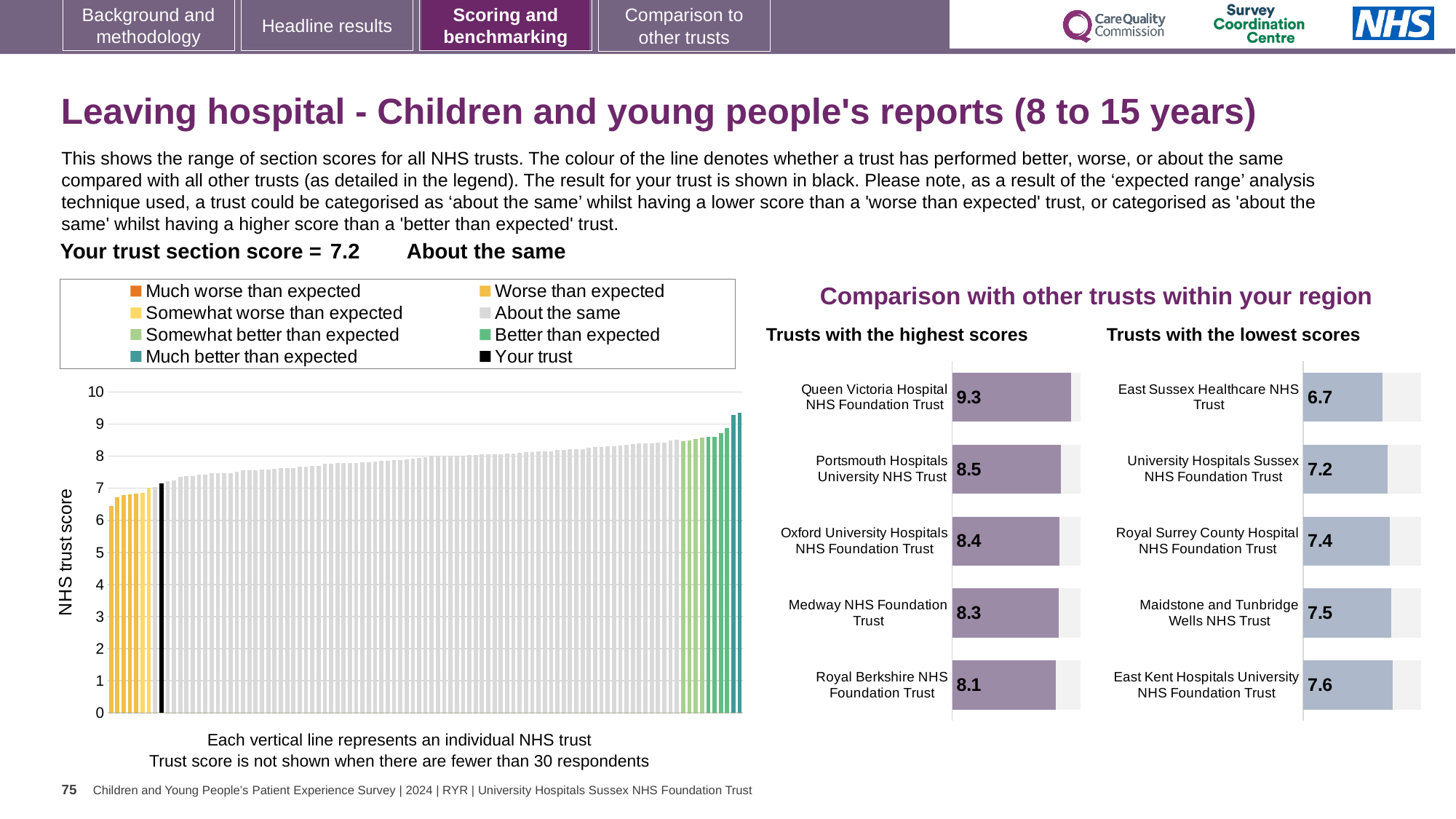
In the main 'NHS trust score' chart, is the value of the black bar (your trust) greater or less than 5? greater In the 'Trusts with the highest scores' chart, what is the score for Queen Victoria Hospital NHS Foundation Trust? 9.3 In the 'Trusts with the highest scores' chart, what is the difference between the scores of Queen Victoria Hospital NHS Foundation Trust and Portsmouth Hospitals University NHS Trust? 0.8 In the 'Trusts with the lowest scores' chart, which trust has the lowest score? East Sussex Healthcare NHS Trust In the 'Trusts with the highest scores' chart, which has the larger score: Oxford University Hospitals NHS Foundation Trust or Medway NHS Foundation Trust? Oxford University Hospitals NHS Foundation Trust In the 'Trusts with the lowest scores' chart, how much higher is East Kent Hospitals University NHS Foundation Trust's score than East Sussex Healthcare NHS Trust's score? 0.9 In the 'Trusts with the lowest scores' chart, what is the score for East Sussex Healthcare NHS Trust? 6.7 What kind of chart is the main chart on the left showing NHS trust scores? Bar chart How many entries does the legend of the main 'NHS trust score' chart list? 8 In the main 'NHS trust score' chart, do the values rise or fall from left to right? Rise How many trusts are listed in the 'Trusts with the lowest scores' chart? 5 In the 'Trusts with the highest scores' chart, which trust has the highest score? Queen Victoria Hospital NHS Foundation Trust